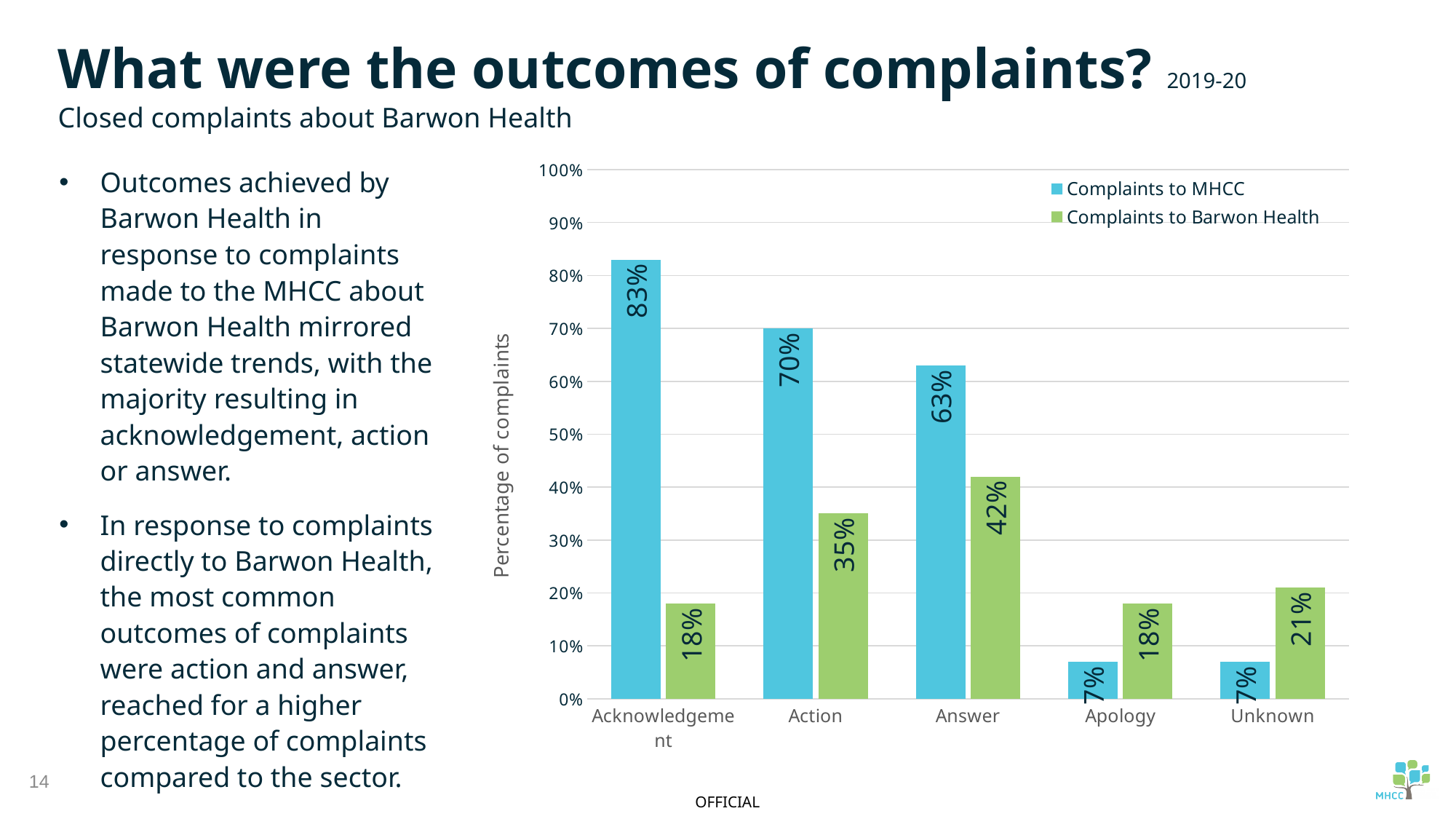
Which outcome category has the highest value for Complaints to MHCC? Acknowledgement What is the label of the vertical axis? Percentage of complaints What percentage of complaints to Barwon Health resulted in Answer? 42% What percentage of complaints to MHCC had an Unknown outcome? 7% How many outcome categories are shown on the x axis? 5 What percentage of complaints to Barwon Health resulted in Action? 35% What is the difference between the Complaints to MHCC and Complaints to Barwon Health values for Action? 35% How many series does the legend list? 2 For Apology, which series has the larger value: Complaints to MHCC or Complaints to Barwon Health? Complaints to Barwon Health What kind of chart is shown on the slide? Bar chart Which outcome category has the lowest value for Complaints to Barwon Health? Acknowledgement and Apology (both 18%) What percentage of complaints to MHCC resulted in Acknowledgement? 83%